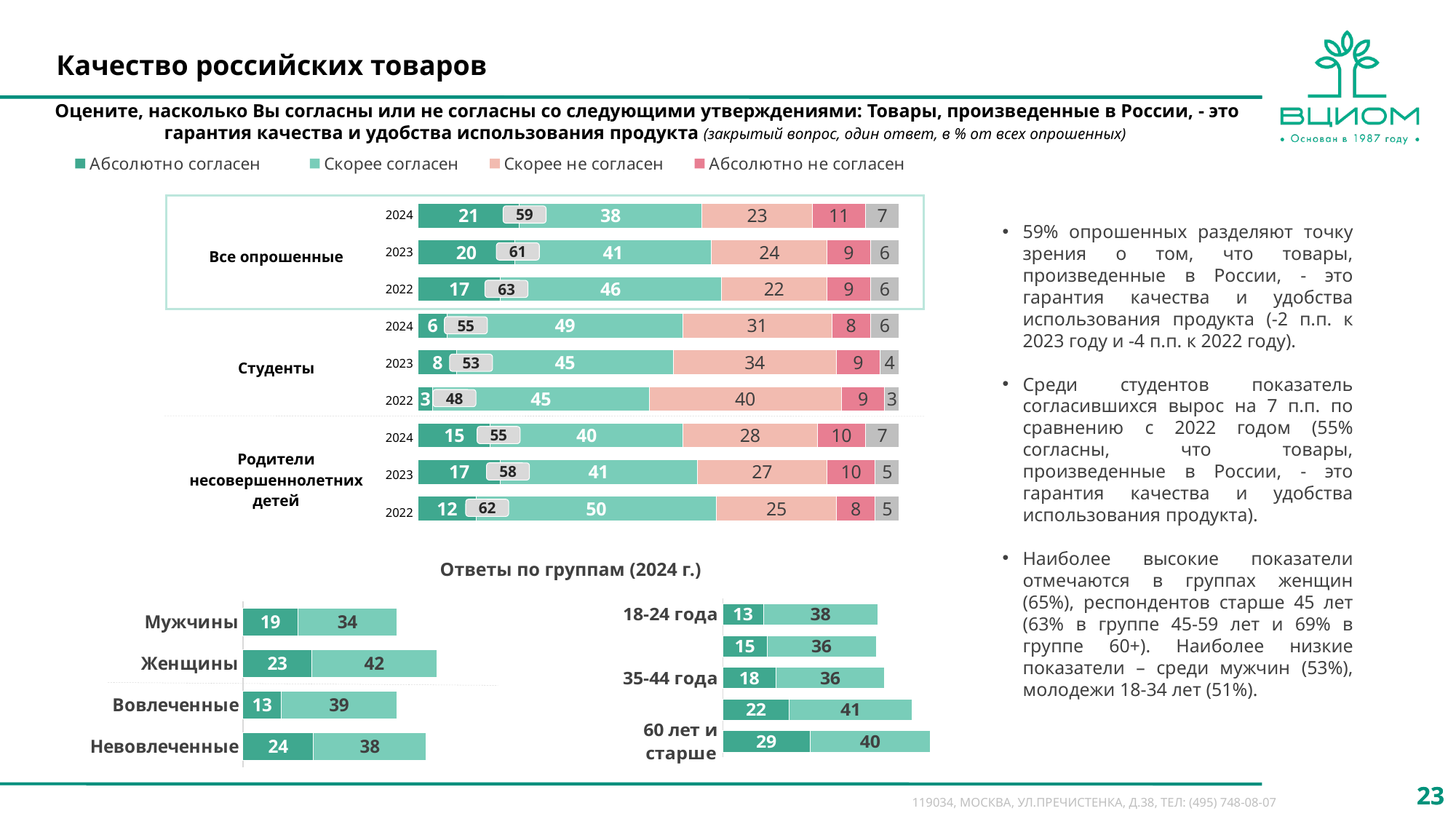
In the top stacked bar chart, what is the value for 'Скорее согласен' among 'Все опрошенные' in 2022? 46 In the top stacked bar chart, what is the value for 'Абсолютно согласен' among 'Все опрошенные' in 2024? 21 In the bottom-left chart 'Ответы по группам (2024 г.)', what is the total of the two segments for 'Женщины'? 65 In the top stacked bar chart, what is the value for 'Скорее не согласен' among 'Студенты' in 2022? 40 In the top stacked bar chart, how does the 'Абсолютно согласен' value for 'Все опрошенные' change from 2022 to 2024? It rises (17 to 21) In the top stacked bar chart, which is larger for 'Скорее согласен' in 2022: 'Родители несовершеннолетних детей' or 'Студенты'? Родители несовершеннолетних детей In the bottom-right chart 'Ответы по группам (2024 г.)', what is the 'Абсолютно согласен' value for '60 лет и старше'? 29 In the top stacked bar chart, what is the difference between the 'Скорее не согласен' values for 'Все опрошенные' in 2023 and 2024? 1 How many series does the legend of the top stacked bar chart list? 4 In the bottom-left chart 'Ответы по группам (2024 г.)', which category has the highest 'Абсолютно согласен' value? Невовлеченные What kind of chart is the top chart on the slide? Stacked bar chart In the bottom-left chart 'Ответы по группам (2024 г.)', what is the 'Абсолютно согласен' value for 'Мужчины'? 19